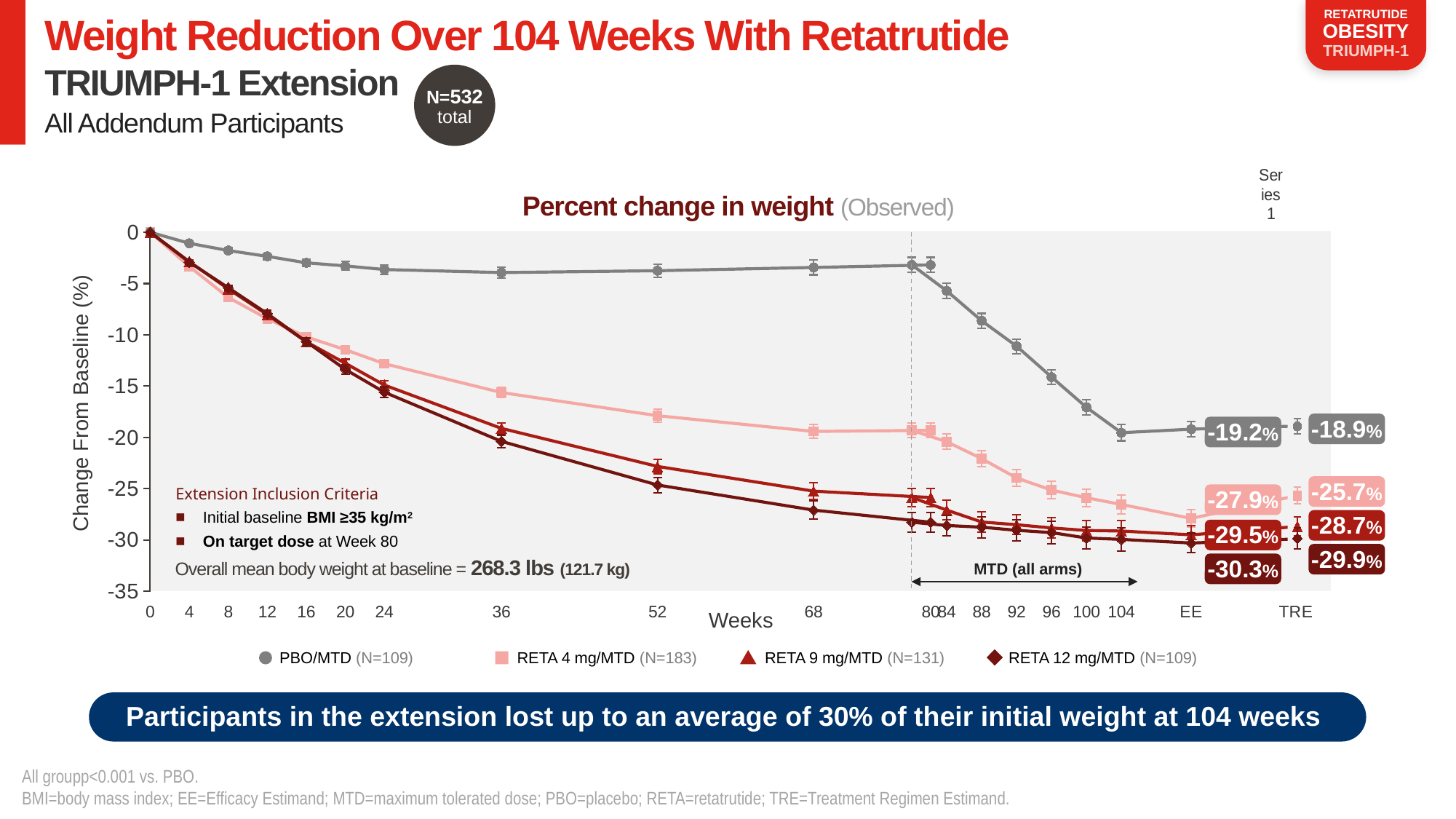
At week 52, which series has the lower value: RETA 4 mg/MTD or RETA 9 mg/MTD? RETA 9 mg/MTD What is the label of the y axis of the chart? Change From Baseline (%) What is the TRE value for RETA 9 mg/MTD? -28.7% What is the EE value for RETA 12 mg/MTD? -30.3% What is the TRE value for PBO/MTD? -18.9% What is the EE value for RETA 4 mg/MTD? -27.9% What kind of chart is shown on the slide? Line chart How many series does the legend of the chart list? 4 Is the value for PBO/MTD at week 52 greater or less than -5? greater Which series has the lowest (most negative) EE value? RETA 12 mg/MTD What is the difference between the EE values for PBO/MTD (-19.2%) and RETA 12 mg/MTD (-30.3%)? 11.1 percentage points